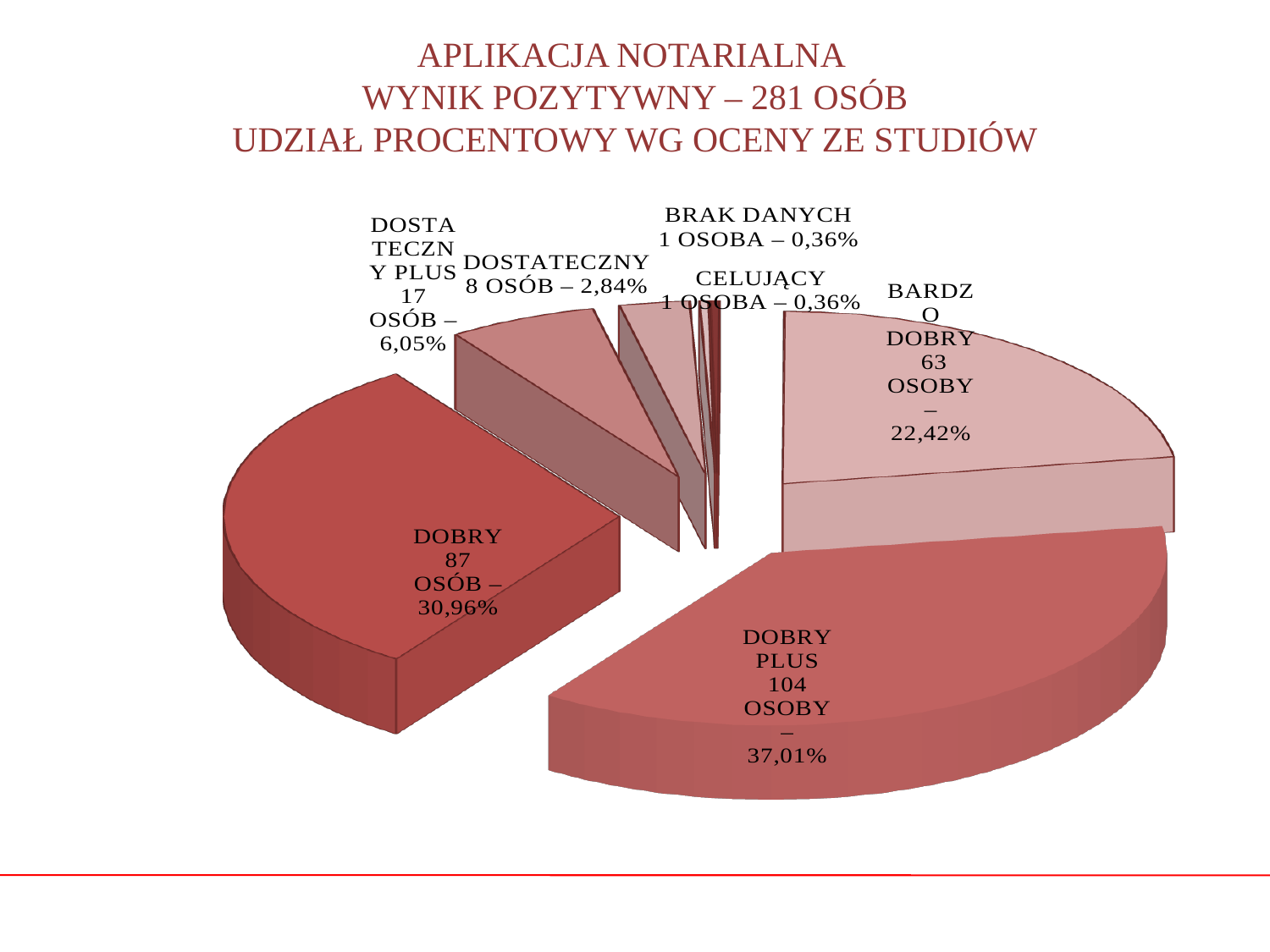
What percentage share does the DOSTATECZNY slice represent? 2,84% How many categories (slices) does the pie chart have? 7 What percentage share does the DOBRY PLUS slice represent? 37,01% What percentage share does the CELUJĄCY slice represent? 0,36% Which is larger, the share for BARDZO DOBRY or the share for DOSTATECZNY PLUS? BARDZO DOBRY Which category has the largest share of the pie? DOBRY PLUS What percentage share does the BARDZO DOBRY slice represent? 22,42% What is the difference in number of people between DOBRY PLUS and DOBRY? 17 How many people are in the DOBRY category? 87 According to the chart title, how many people in total achieved a positive result? 281 How many people are in the DOSTATECZNY PLUS category? 17 What type of chart is shown on the slide? Pie chart